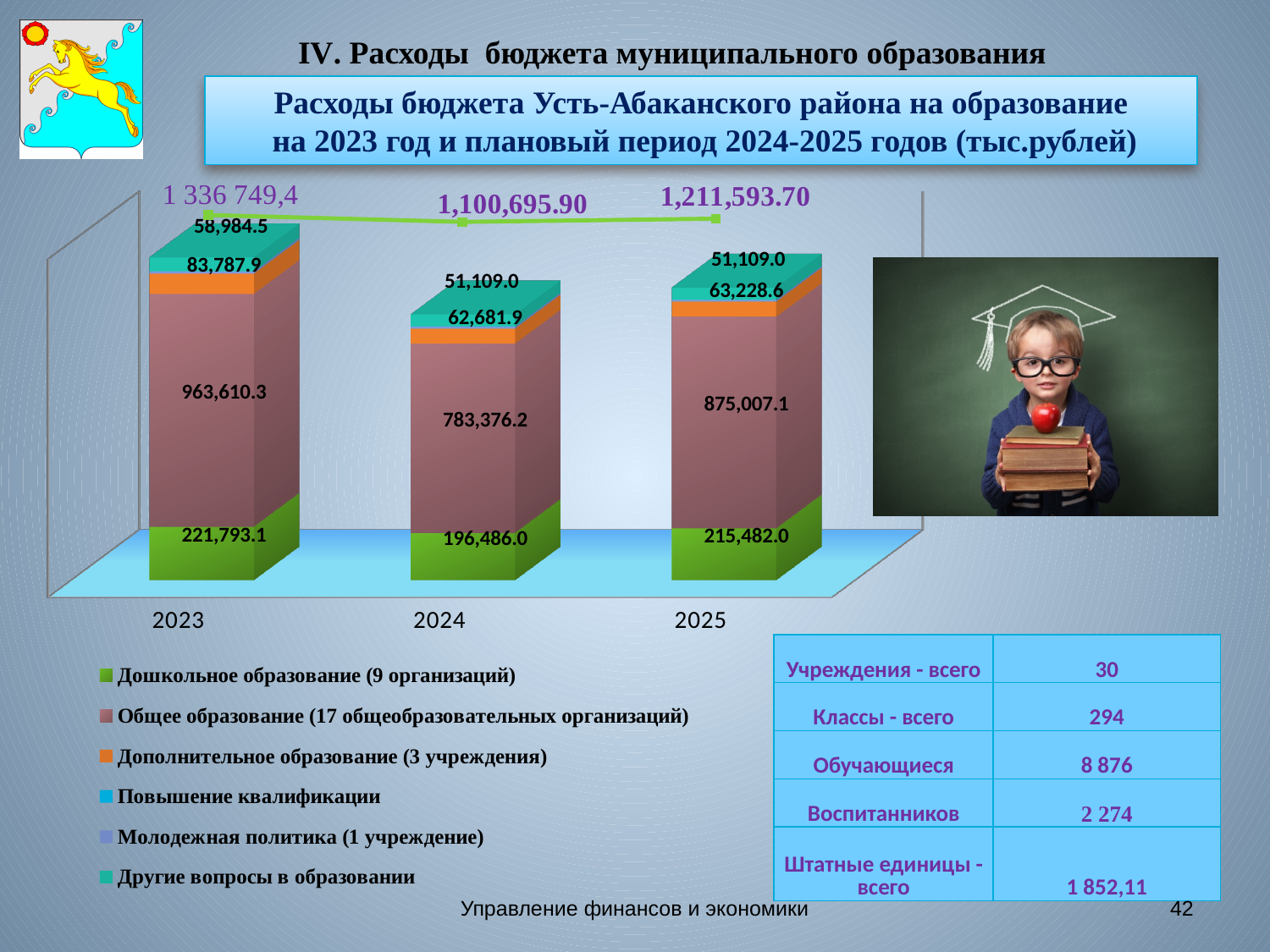
What is the value of the Дошкольное образование segment for 2025? 215,482.0 What is the value of the Общее образование segment for 2025? 875,007.1 How many series does the chart legend list? 6 What is the value of the Общее образование segment for 2024? 783,376.2 What kind of chart is shown on the slide? stacked bar chart Which is larger, the Общее образование value for 2023 or for 2024? 2023 What is the total shown above the bar for 2024? 1,100,695.90 What is the value of the Дошкольное образование segment for 2023? 221,793.1 How many years (bars) are shown on the x axis of the chart? 3 What is the total shown above the bar for 2023? 1 336 749,4 What is the difference between the Дошкольное образование values for 2023 and 2024? 25,307.1 Which year has the lowest total education expenditure? 2024